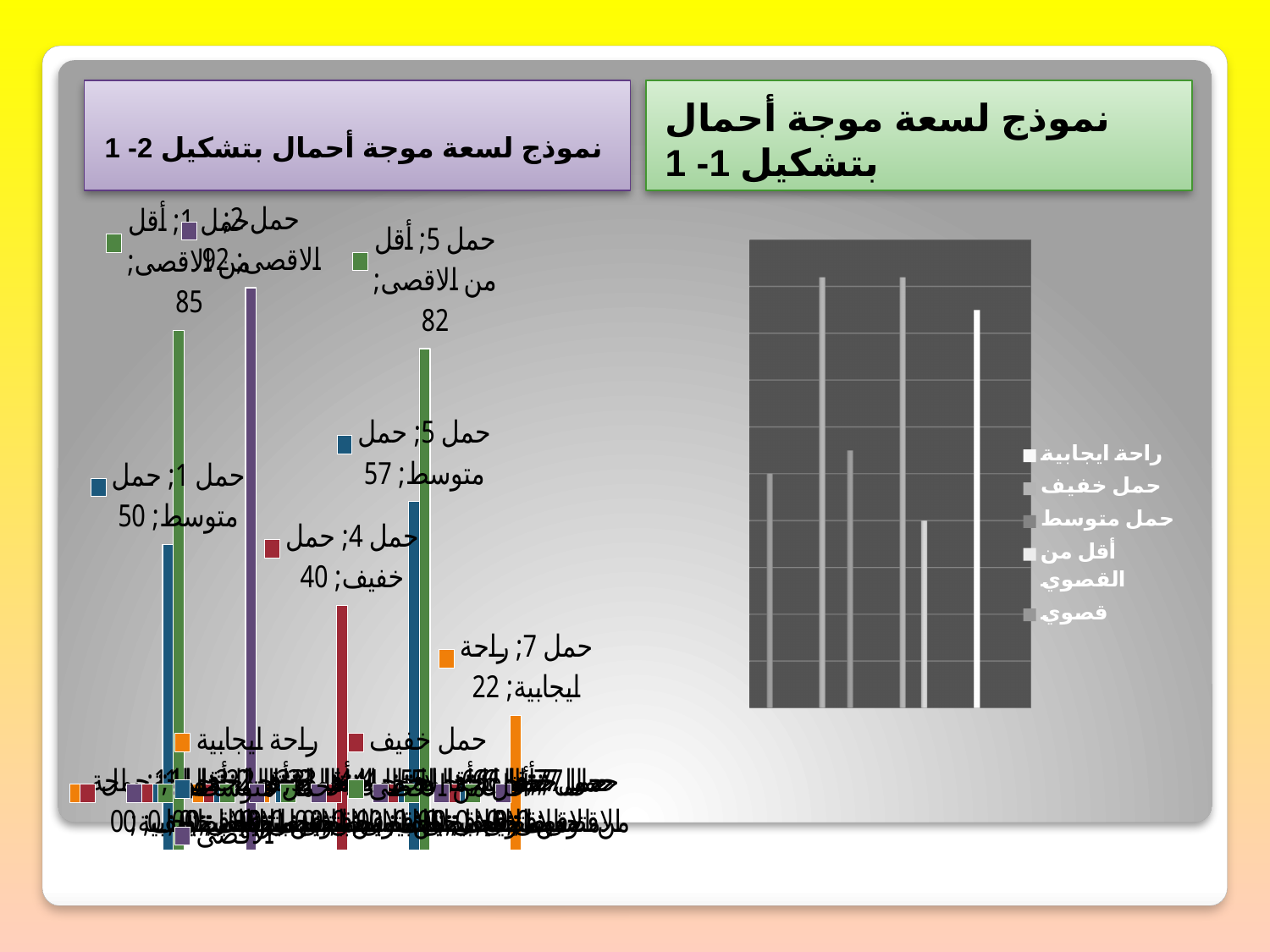
What kind of chart is the right chart titled 'نموذج لسعة موجة أحمال بتشكيل 1-1'? bar chart How many entries does the legend of the right chart ('نموذج لسعة موجة أحمال بتشكيل 1-1') list? 5 In the left chart ('بتشكيل 2-1'), what is the value labelled for حمل 5, حمل متوسط? 57 In the left chart ('بتشكيل 2-1'), what is the value labelled for حمل 4, حمل خفيف? 40 In the left chart ('بتشكيل 2-1'), what is the difference between the حمل متوسط values for حمل 5 (57) and حمل 1 (50)? 7 In the left chart ('بتشكيل 2-1'), what is the difference between the حمل 4 حمل خفيف value and the حمل 7 راحة ايجابية value? 18 What kind of chart is the left chart titled 'نموذج لسعة موجة أحمال بتشكيل 2-1'? bar chart In the left chart ('بتشكيل 2-1'), which is larger: the value for حمل 4 حمل خفيف or the value for حمل 7 راحة ايجابية? حمل 4 حمل خفيف In the left chart ('بتشكيل 2-1'), what is the value labelled for حمل 7, راحة ايجابية? 22 In the left chart ('بتشكيل 2-1'), what is the value labelled for حمل 5, أقل من الاقصى? 82 In the left chart ('بتشكيل 2-1'), what is the value labelled for حمل 1, حمل متوسط? 50 What is the title of the chart on the right side of the slide? نموذج لسعة موجة أحمال بتشكيل 1-1